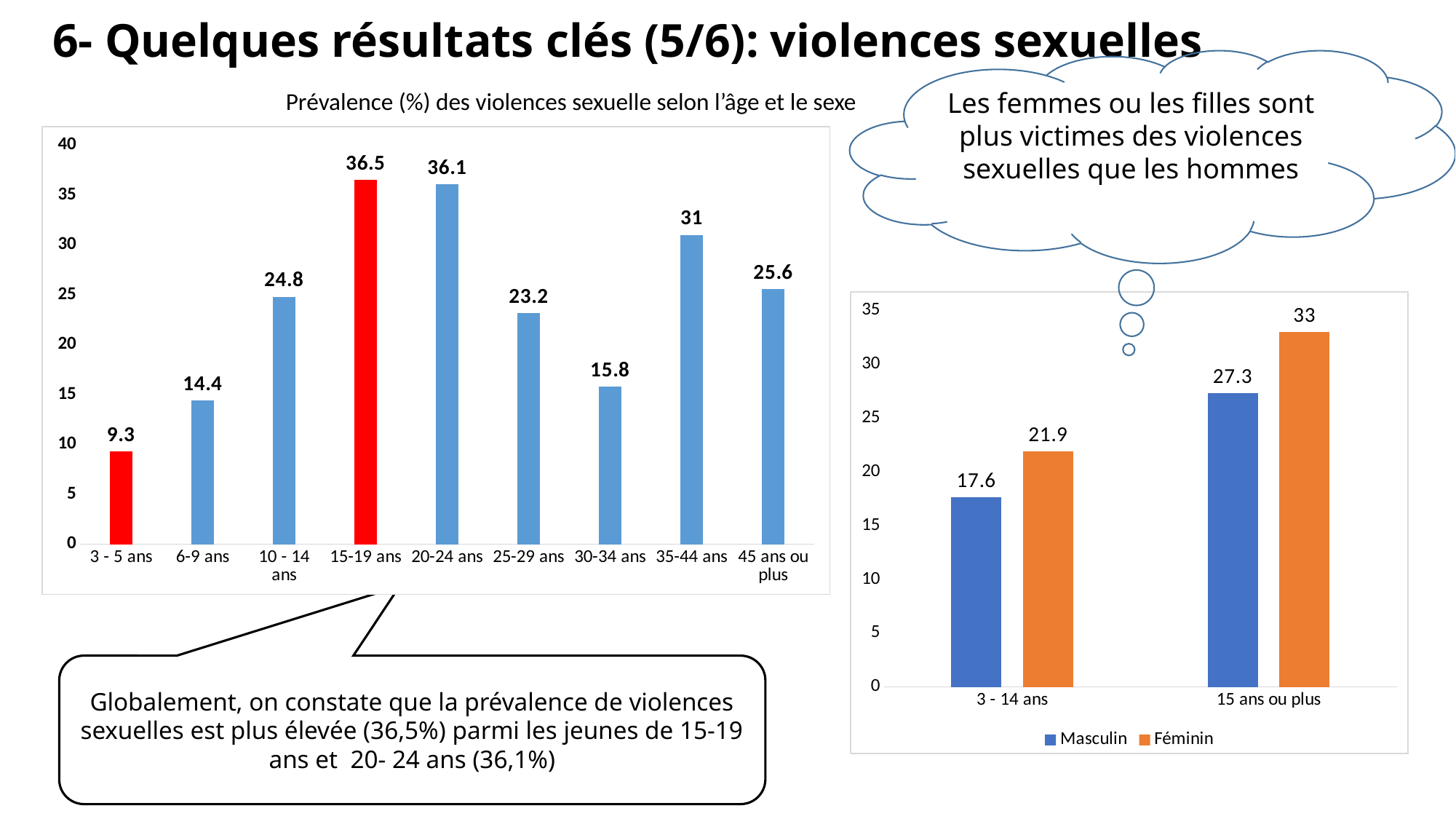
In the right chart, what is the Féminin value for 15 ans ou plus? 33 In the left chart, which is larger: the value for 25-29 ans or 30-34 ans? 25-29 ans In the left chart, which age group has the highest value? 15-19 ans In the left chart, what is the difference between the values for 10 - 14 ans and 6-9 ans? 10.4 In the left chart (Prévalence des violences sexuelle selon l'âge et le sexe), what is the value for 15-19 ans? 36.5 In the left chart, what is the value for 35-44 ans? 31 In the left chart, which age group has the lowest value? 3 - 5 ans In the right chart, how many series does the legend list? 2 In the left chart, how many age groups are shown? 9 In the left chart, which bars are coloured red? 3 - 5 ans and 15-19 ans What type of chart is the right chart? Bar chart In the right chart, what is the difference between the Féminin and Masculin values for 3 - 14 ans? 4.3